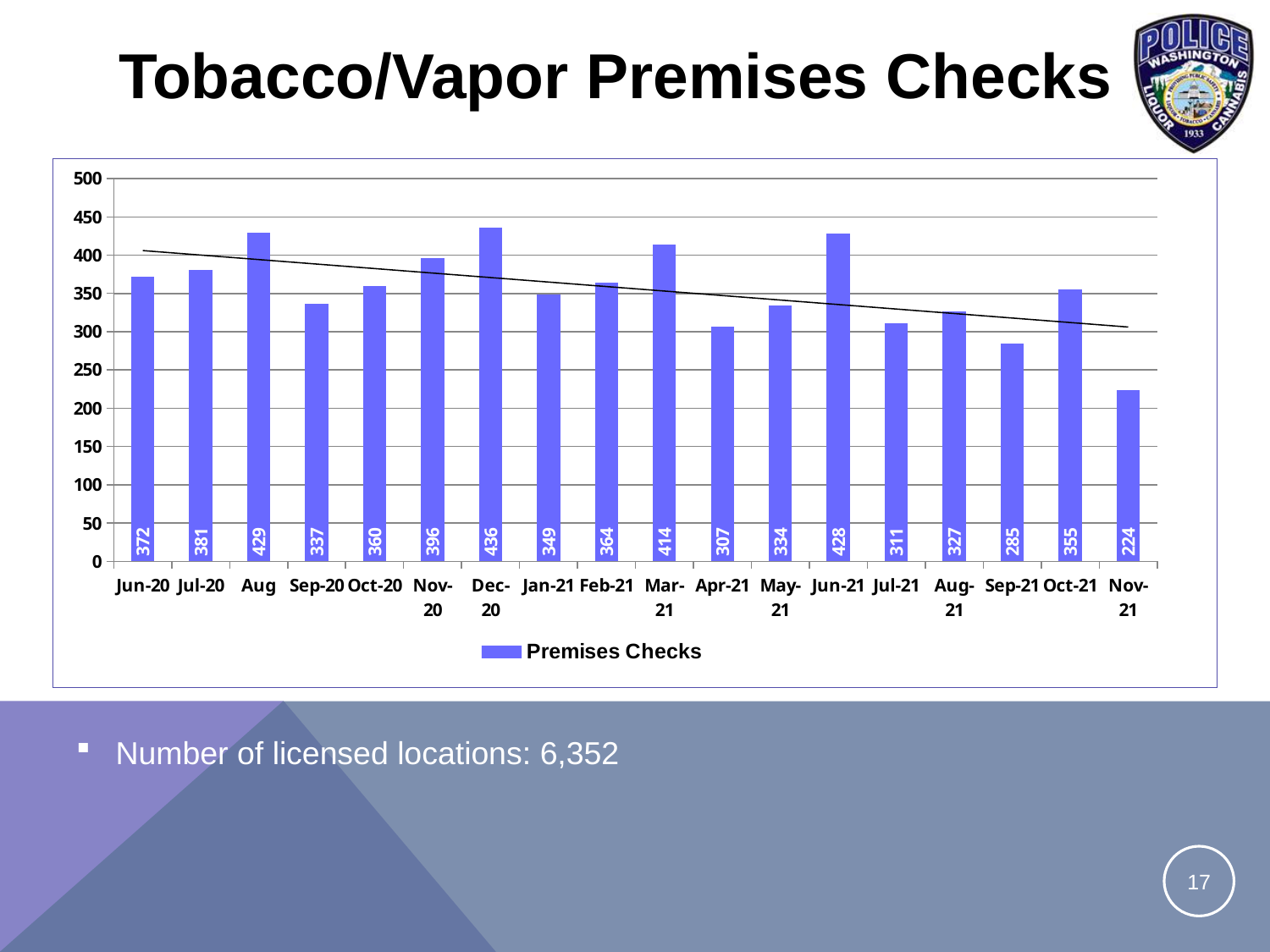
What is the name of the series shown in the legend? Premises Checks Which is larger, the Premises Checks for Mar-21 or Jun-21? Jun-21 Which month has the lowest number of Premises Checks? Nov-21 What kind of chart is shown on the slide? bar chart What is the value of Premises Checks for Nov-21? 224 How many series does the legend list? 1 What is the value of Premises Checks for Dec-20? 436 Which month has the highest number of Premises Checks? Dec-20 How many months are shown on the x axis? 18 What is the difference between the Premises Checks for Aug-20 and Sep-20? 92 Is the value for Sep-21 greater or less than 300? less What is the value of Premises Checks for Apr-21? 307